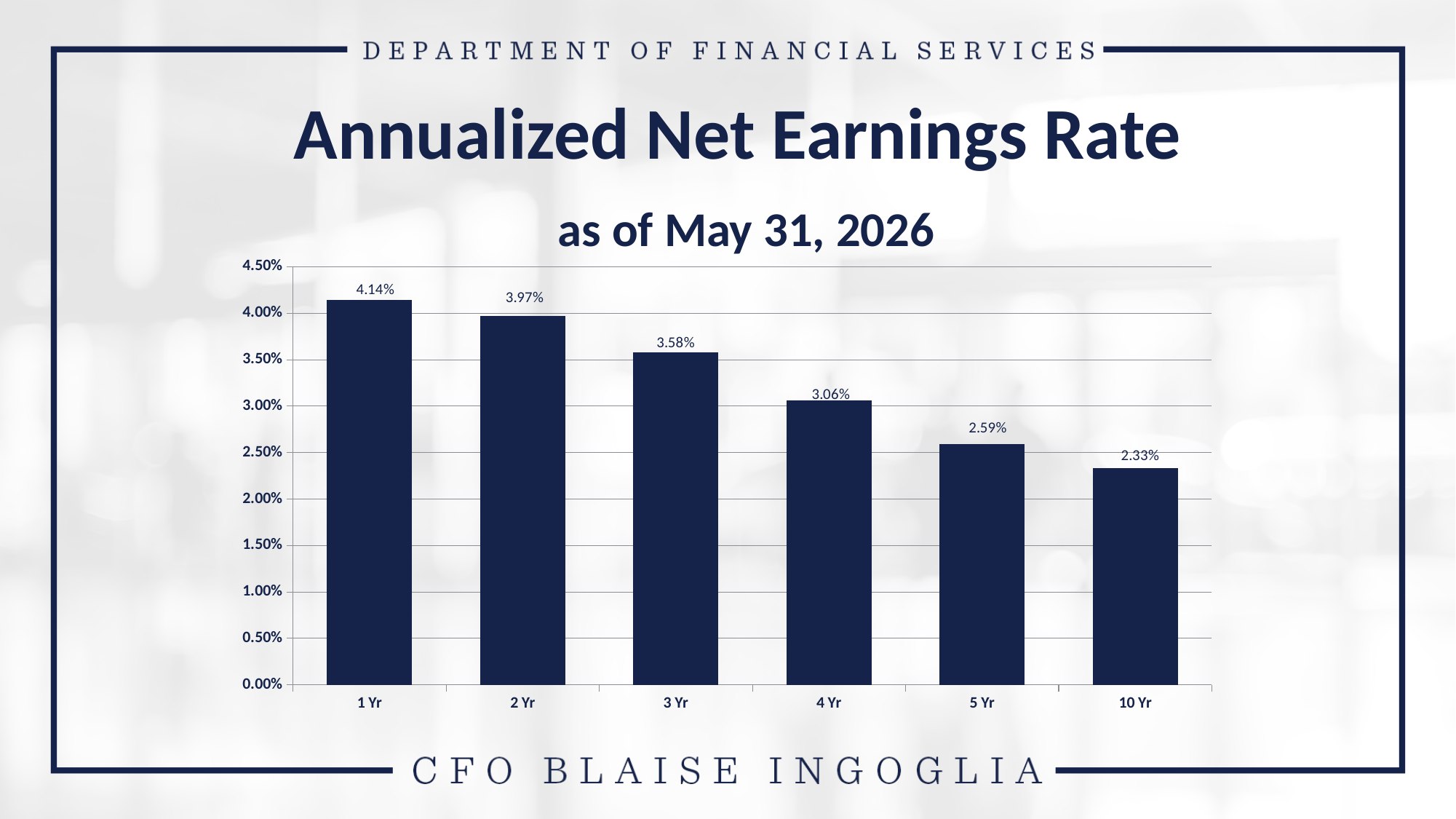
Which is larger, the 3 Yr rate or the 4 Yr rate? 3 Yr Which period has the lowest annualized net earnings rate? 10 Yr What is the difference between the 1 Yr and 2 Yr annualized net earnings rates? 0.17% What is the annualized net earnings rate for 3 Yr? 3.58% How many periods are shown on the chart? 6 Which period has the highest annualized net earnings rate? 1 Yr What is the difference between the 4 Yr and 10 Yr annualized net earnings rates? 0.73% What is the annualized net earnings rate for 5 Yr? 2.59% What is the annualized net earnings rate for 10 Yr? 2.33% Do the annualized net earnings rates rise or fall from 1 Yr to 10 Yr? Fall What kind of chart is shown on the slide? Bar chart What is the annualized net earnings rate for 1 Yr? 4.14%